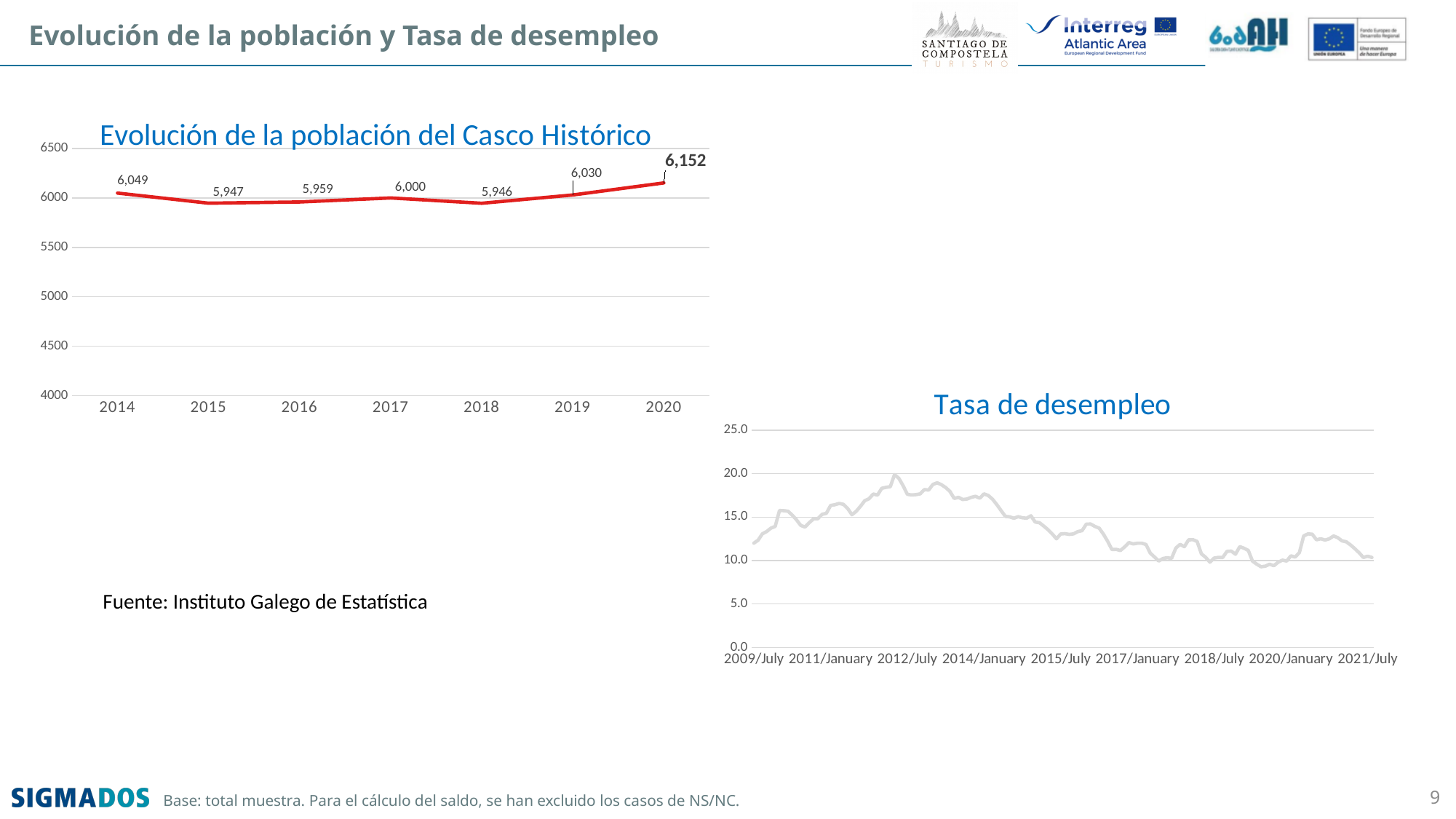
In the chart 'Evolución de la población del Casco Histórico', what was the population in 2014? 6,049 In the chart 'Evolución de la población del Casco Histórico', what is the difference between the population in 2020 and in 2014? 103 In the chart 'Tasa de desempleo', is the value at 2012/July greater or less than 15.0? greater In the chart 'Evolución de la población del Casco Histórico', which year has a larger population, 2019 or 2016? 2019 In the chart 'Evolución de la población del Casco Histórico', which year has the highest population? 2020 What kind of chart is 'Evolución de la población del Casco Histórico'? Line chart How many years are plotted in the chart 'Evolución de la población del Casco Histórico'? 7 In the chart 'Tasa de desempleo', does the unemployment rate generally rise or fall from 2012/July to 2021/July? Fall In the chart 'Evolución de la población del Casco Histórico', what was the population in 2020? 6,152 In the chart 'Evolución de la población del Casco Histórico', which year has the lowest population? 2018 In the chart 'Evolución de la población del Casco Histórico', what was the population in 2017? 6,000 In the chart 'Tasa de desempleo', is the value at 2021/July greater or less than 15.0? less